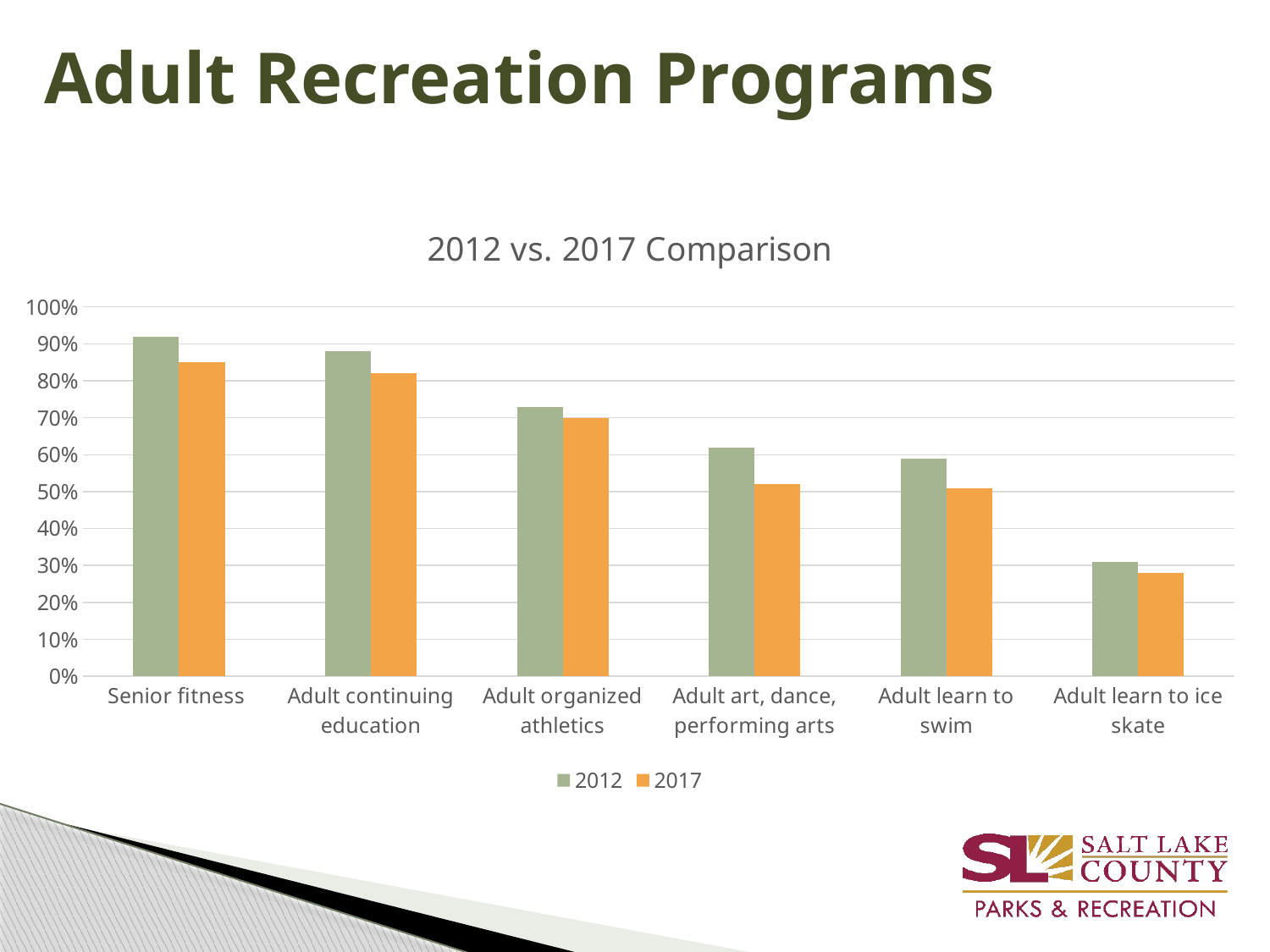
How many program categories are shown on the x axis? 6 What kind of chart is shown on the slide? bar chart Is the 2017 value for Adult art, dance, performing arts greater or less than 60%? less How many series does the legend list? 2 Is the 2012 value for Senior fitness greater or less than 90%? greater Is the 2012 value for Adult continuing education greater or less than 80%? greater What is the title of the chart? 2012 vs. 2017 Comparison For Adult learn to swim, which is larger, the 2012 value or the 2017 value? 2012 Which category has the lowest 2017 value? Adult learn to ice skate Do the 2012 values rise or fall moving left to right across the categories? fall Which category has the highest 2012 value? Senior fitness